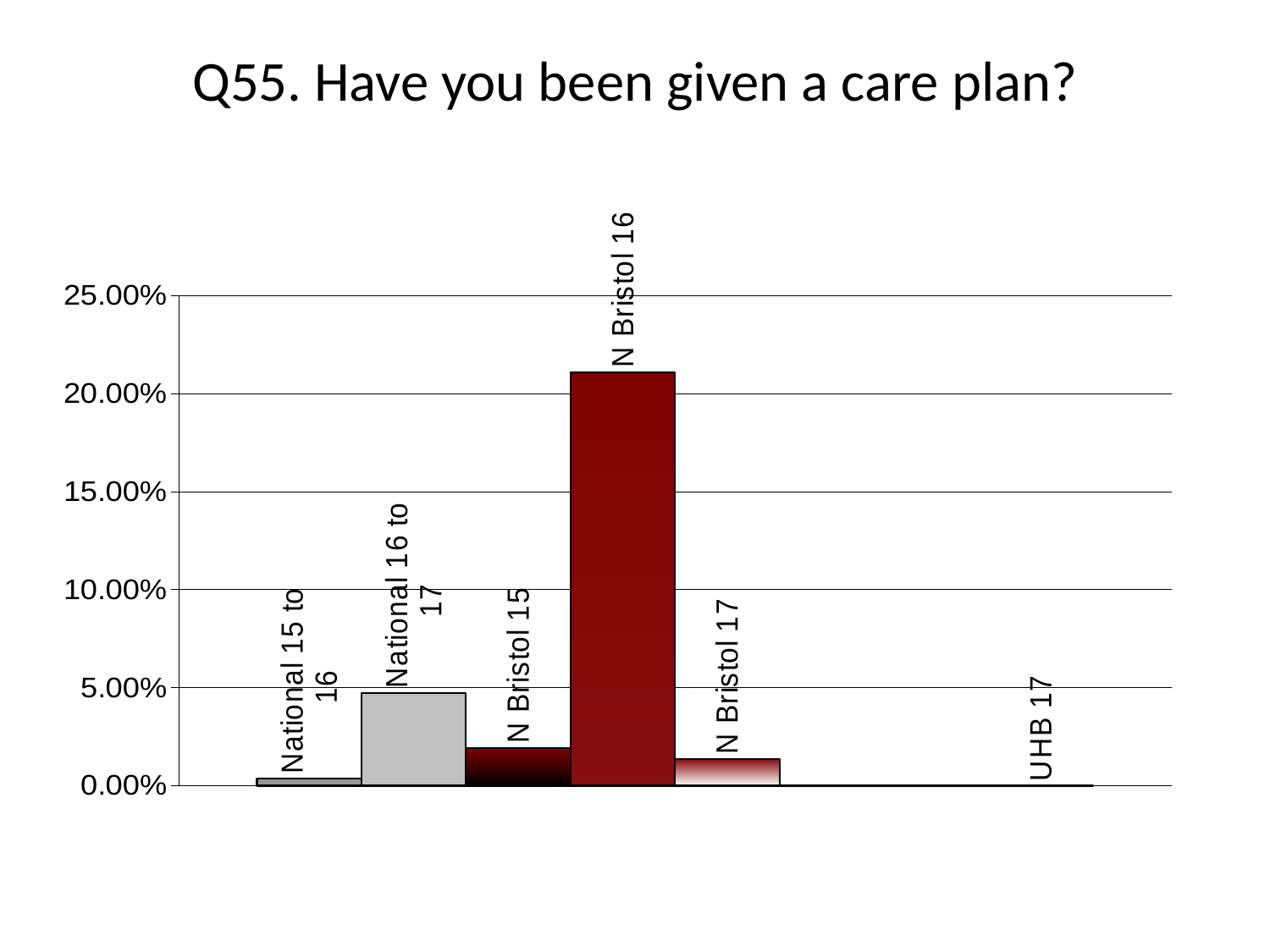
Is the value for N Bristol 15 greater or less than 5.00%? less Is the value for N Bristol 16 greater or less than 20.00%? greater How many categories are plotted in the chart? 6 What is the title of the chart? Q55. Have you been given a care plan? What is the highest value shown on the vertical axis? 25.00% Which is larger, the value for National 16 to 17 or the value for N Bristol 15? National 16 to 17 Which is larger, the value for National 16 to 17 or the value for National 15 to 16? National 16 to 17 Which category has the highest value? N Bristol 16 Is the value for N Bristol 16 greater or less than 25.00%? less Which is larger, the value for N Bristol 16 or the value for National 16 to 17? N Bristol 16 What kind of chart is shown on the slide? Bar chart